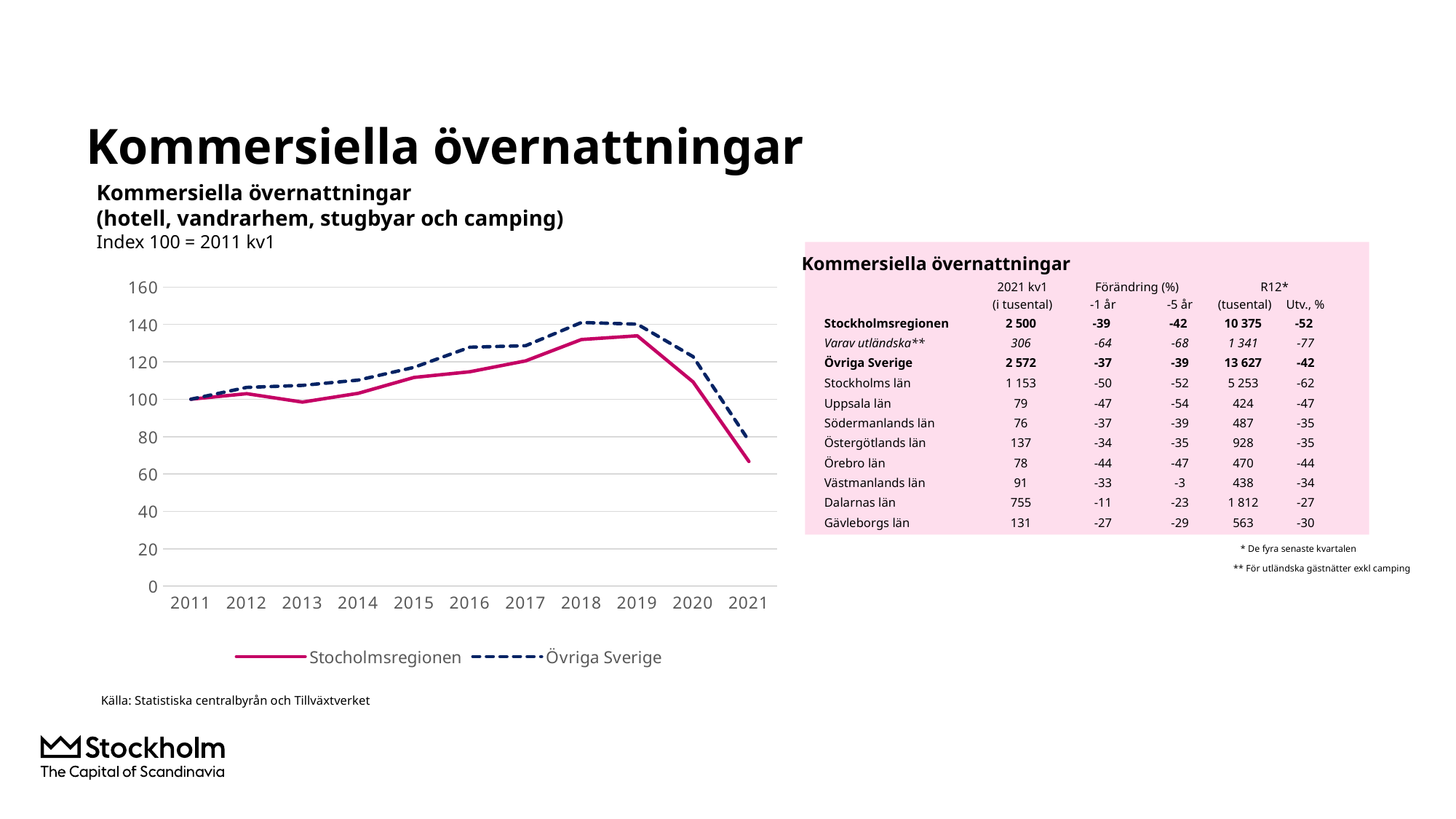
Is the value for Övriga Sverige in 2018 greater or less than 120? greater What kind of chart is shown on the slide? line chart What is the index value for Stocholmsregionen in 2011? 100 In 2019, which series has the higher value, Stocholmsregionen or Övriga Sverige? Övriga Sverige How many series does the chart legend list? 2 Is the value for Stocholmsregionen in 2016 greater or less than 120? less Is the value for Stocholmsregionen in 2021 greater or less than 80? less Which series is drawn with a dashed line in the chart? Övriga Sverige In which year is the Stocholmsregionen series at its lowest? 2021 Does the Stocholmsregionen line rise or fall between 2019 and 2021? fall How many years are shown on the x axis of the chart? 11